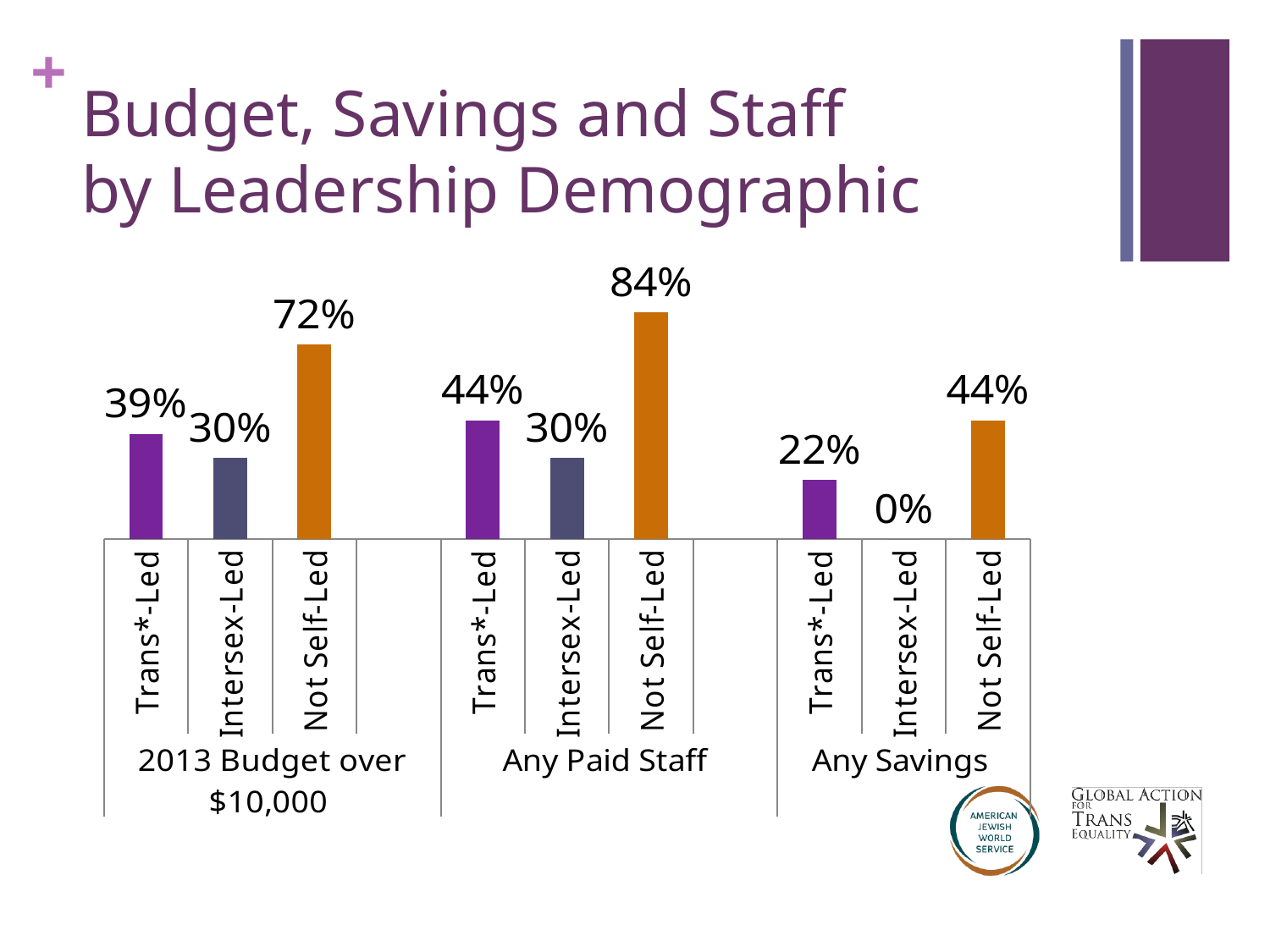
What is the value for Trans*-Led under 2013 Budget over $10,000? 39% Which bar has the highest value on the chart? Not Self-Led under Any Paid Staff What is the value for Not Self-Led under Any Paid Staff? 84% Which is larger: Trans*-Led under Any Paid Staff or Intersex-Led under Any Paid Staff? Trans*-Led under Any Paid Staff How many category groups are shown along the x axis? 3 What is the value for Trans*-Led under Any Savings? 22% What kind of chart is shown on the slide? Bar chart How many bars are plotted on the chart? 9 What is the difference between Not Self-Led and Trans*-Led under 2013 Budget over $10,000? 33% Which bar has the lowest value on the chart? Intersex-Led under Any Savings What is the value for Intersex-Led under Any Savings? 0% What is the difference between Not Self-Led and Intersex-Led under Any Paid Staff? 54%